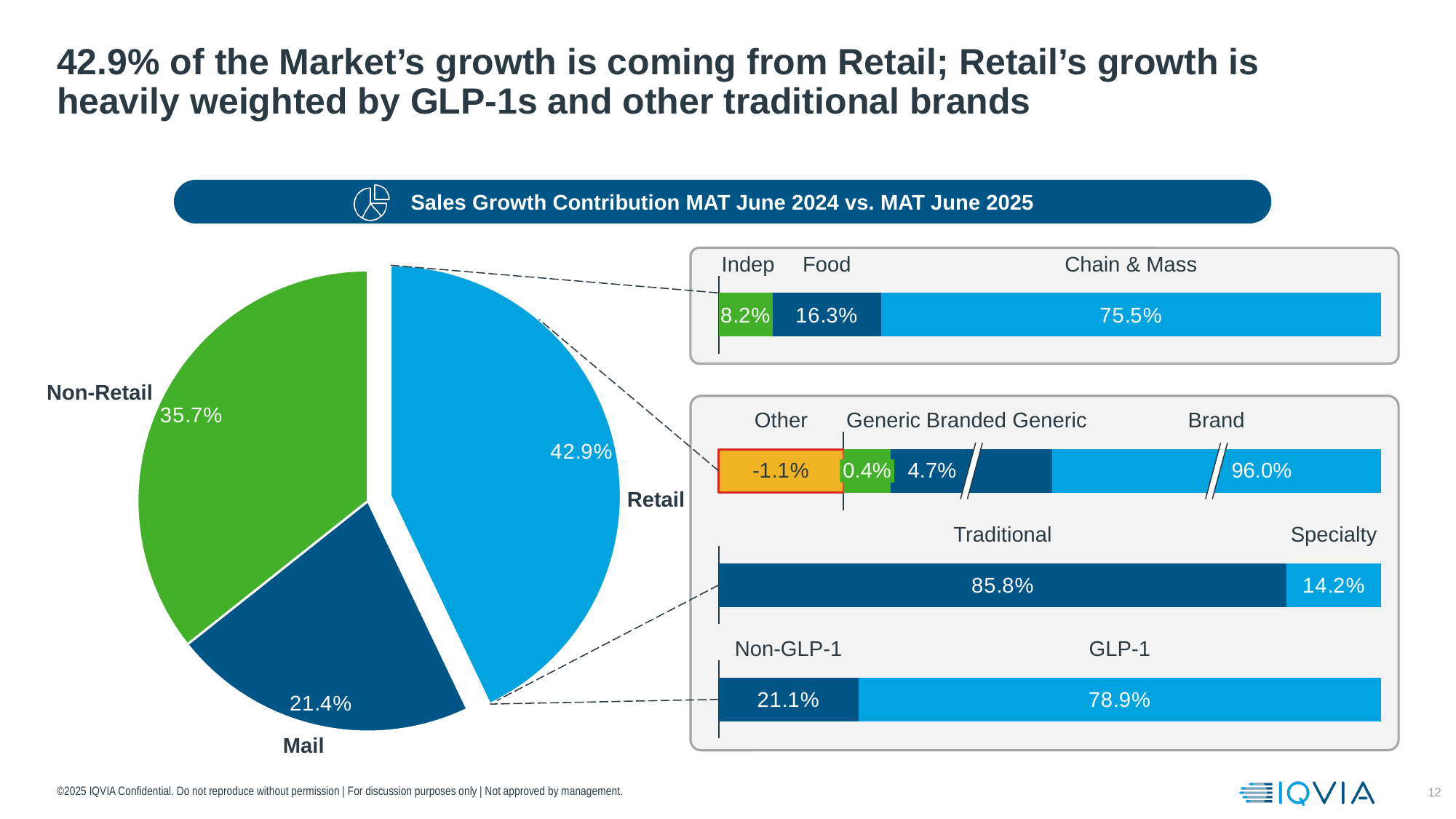
In the top stacked bar (Indep / Food / Chain & Mass), which segment is the smallest? Indep How many slices does the pie chart have? 3 In the top stacked bar (Indep / Food / Chain & Mass), what is the value for Chain & Mass? 75.5% In the bottom stacked bar, which is larger, Non-GLP-1 or GLP-1? GLP-1 In the pie chart, what share of sales growth contribution comes from Retail? 42.9% In the Traditional / Specialty stacked bar, what is the value for Specialty? 14.2% In the pie chart, which slice is the smallest? Mail In the pie chart, what is the difference between the Retail and Non-Retail shares? 7.2% What is the title shown in the banner above the charts? Sales Growth Contribution MAT June 2024 vs. MAT June 2025 In the pie chart, which slice is the largest? Retail In the pie chart, what is the value for Mail? 21.4% In the stacked bar showing Other / Generic / Branded Generic / Brand, what is the value for Other? -1.1%